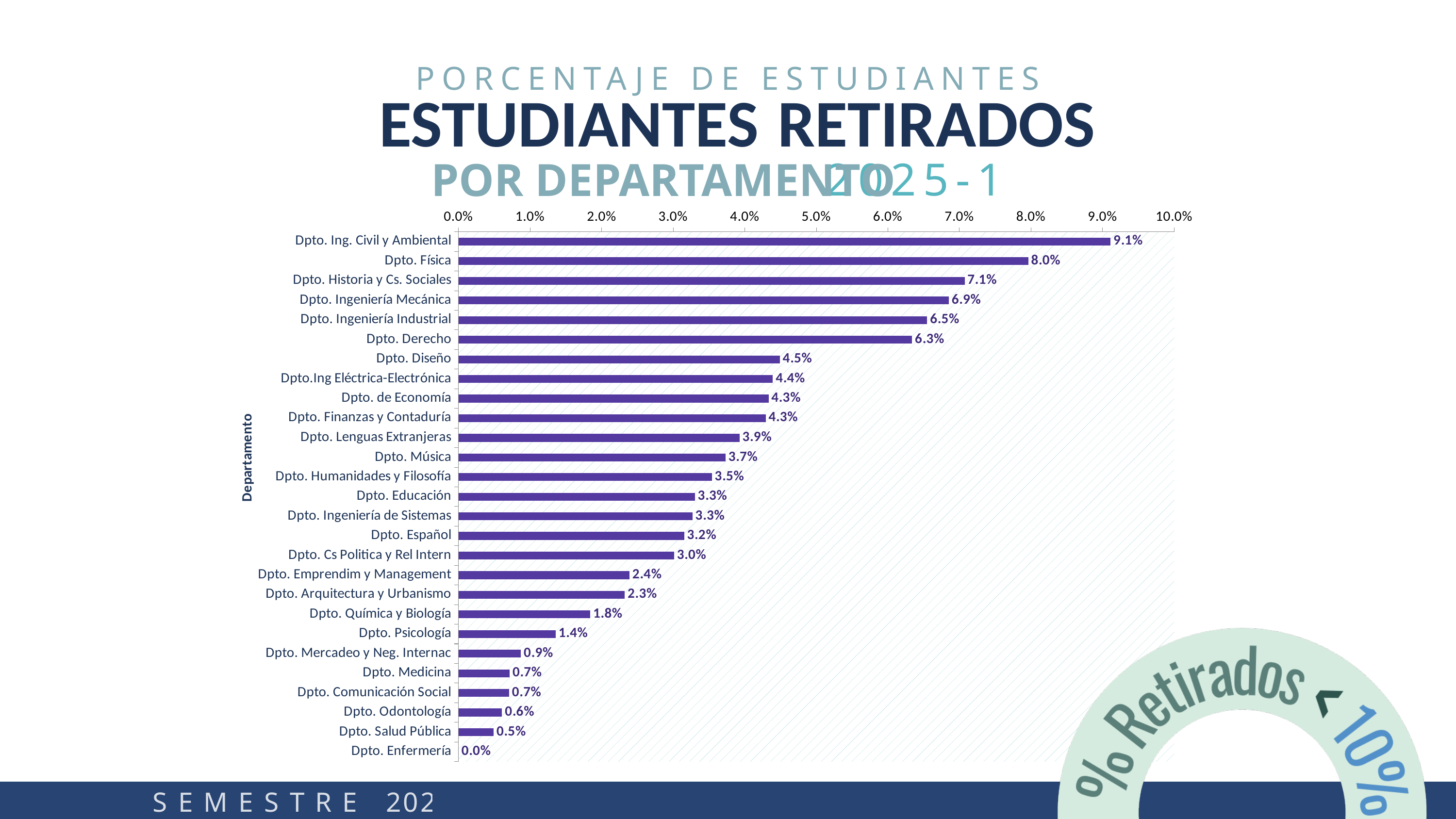
Which is larger, the value for Dpto. Ingeniería Mecánica or Dpto. Ingeniería Industrial? Dpto. Ingeniería Mecánica What is the difference between the values for Dpto. Diseño and Dpto. Música? 0.8% Which department has the highest percentage of withdrawn students? Dpto. Ing. Civil y Ambiental What is the value for Dpto. Física? 8.0% What is the value for Dpto. Derecho? 6.3% What kind of chart is shown on the slide? Bar chart What is the value for Dpto. Lenguas Extranjeras? 3.9% Which department has the lowest percentage of withdrawn students? Dpto. Enfermería What is the value for Dpto. Psicología? 1.4% How many departments are shown in the chart? 27 What is the label of the vertical axis of the chart? Departamento What is the difference between the values for Dpto. Ing. Civil y Ambiental and Dpto. Física? 1.1%